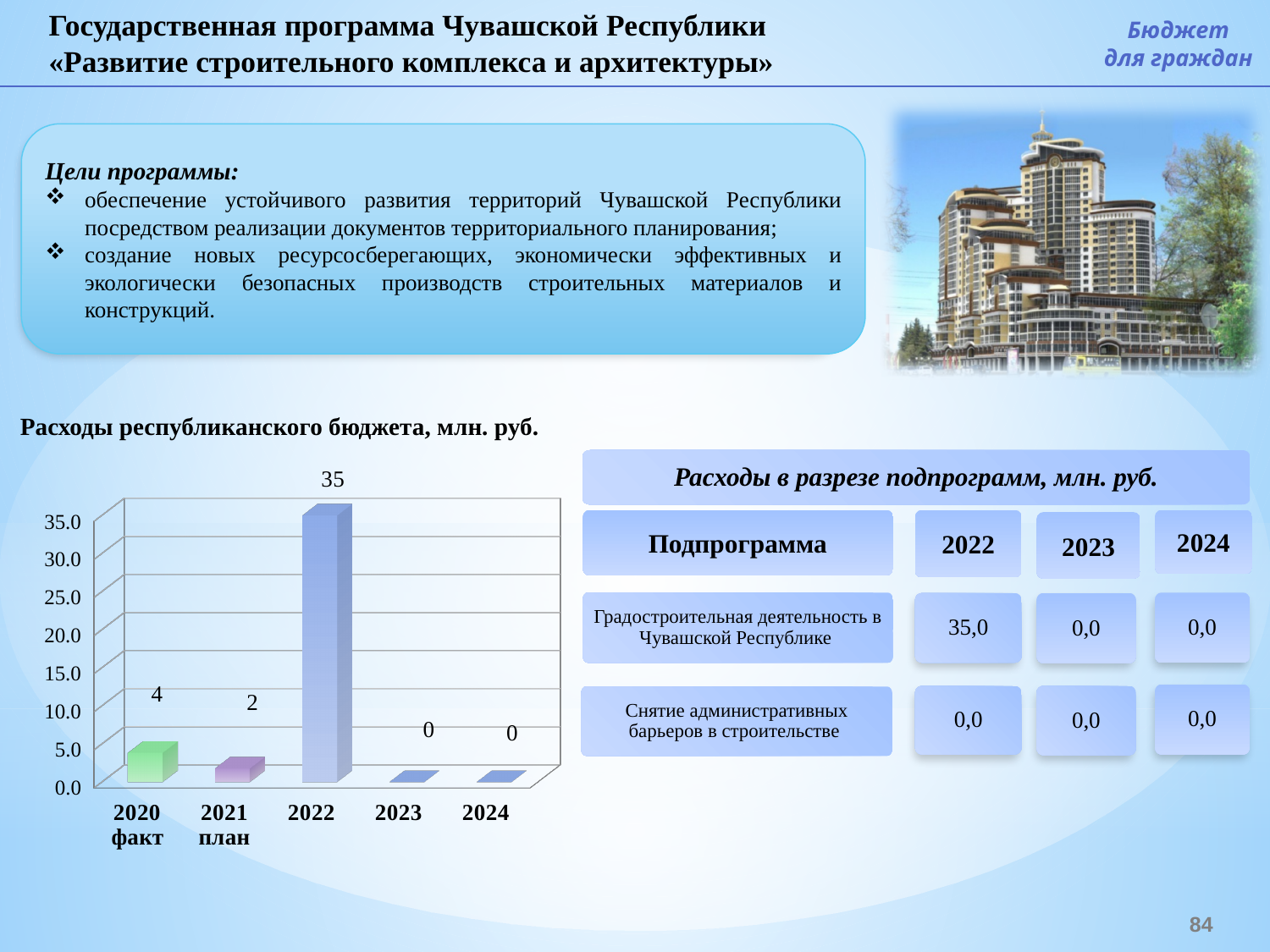
How many categories are shown on the x axis of the chart? 5 What is the value for 2023 in the chart? 0 Which category has the highest value in the chart? 2022 What kind of chart is shown on the slide? bar chart What is the difference between the values for 2020 факт and 2021 план? 2 Is the value for 2022 greater or less than 30.0? greater What is the difference between the values for 2022 and 2020 факт? 31 Which is larger, the value for 2020 факт or the value for 2021 план? 2020 факт What is the value for 2021 план in the chart? 2 What is the value for 2022 in the chart 'Расходы республиканского бюджета, млн. руб.'? 35 What is the title of the chart on the slide? Расходы республиканского бюджета, млн. руб. What is the value for 2020 факт in the chart? 4